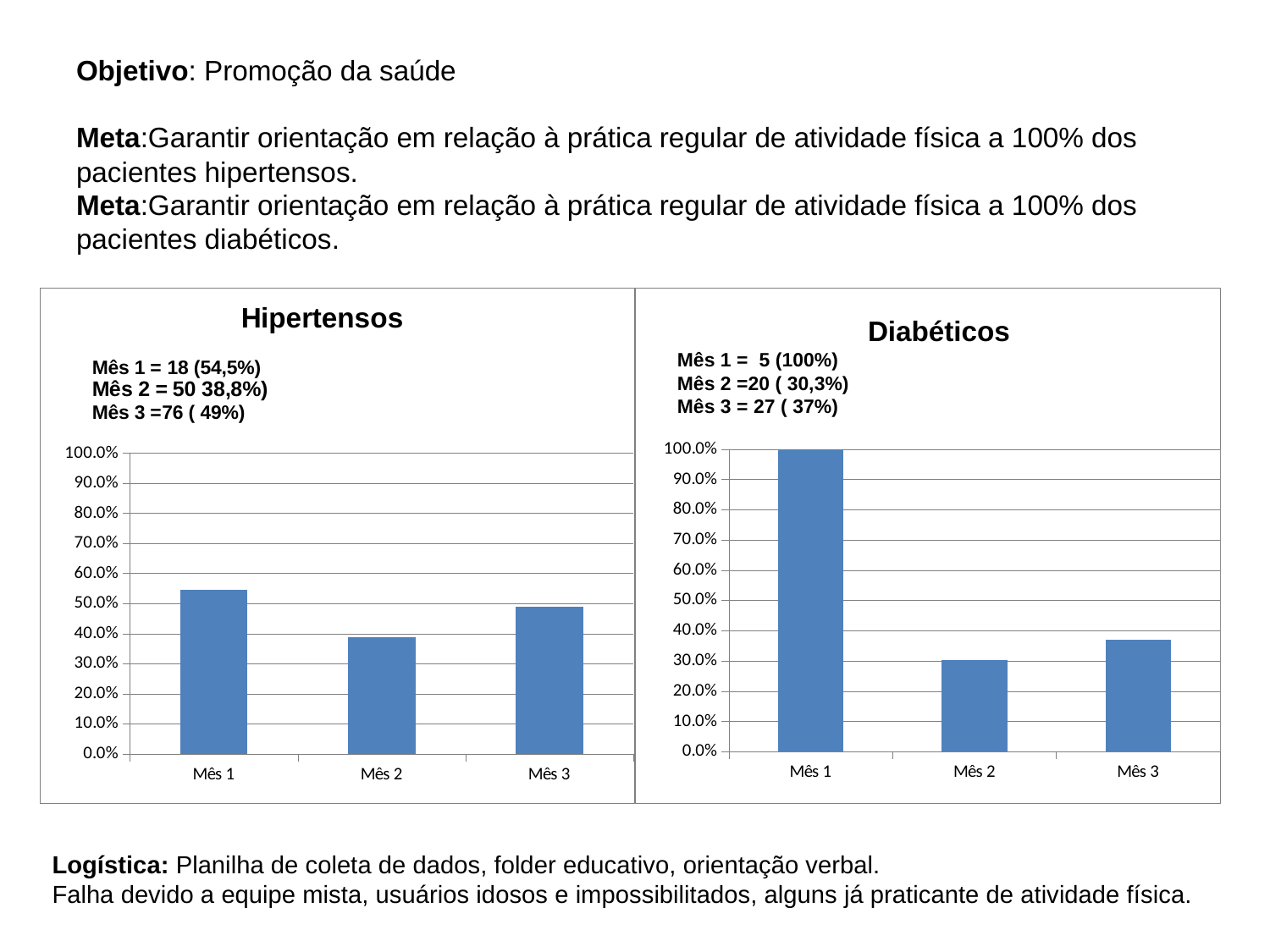
In the Diabéticos chart, which month has the lowest value? Mês 2 How many months are shown on the x axis of the Diabéticos chart? 3 In the Hipertensos chart, what is the value for Mês 1? 54,5% In the Diabéticos chart, what is the value for Mês 2? 30,3% In the Diabéticos chart, which month has the highest value? Mês 1 In the Hipertensos chart, is the value for Mês 3 greater or less than 40.0%? greater What kind of chart is the Hipertensos chart? Bar chart What is the title of the chart on the right side of the slide? Diabéticos In the Diabéticos chart, is the value for Mês 3 greater or less than 40.0%? less In the Hipertensos chart, which is larger, the value for Mês 2 or the value for Mês 3? Mês 3 In the Hipertensos chart, which month has the lowest value? Mês 2 In the Hipertensos chart, which month has the highest value? Mês 1